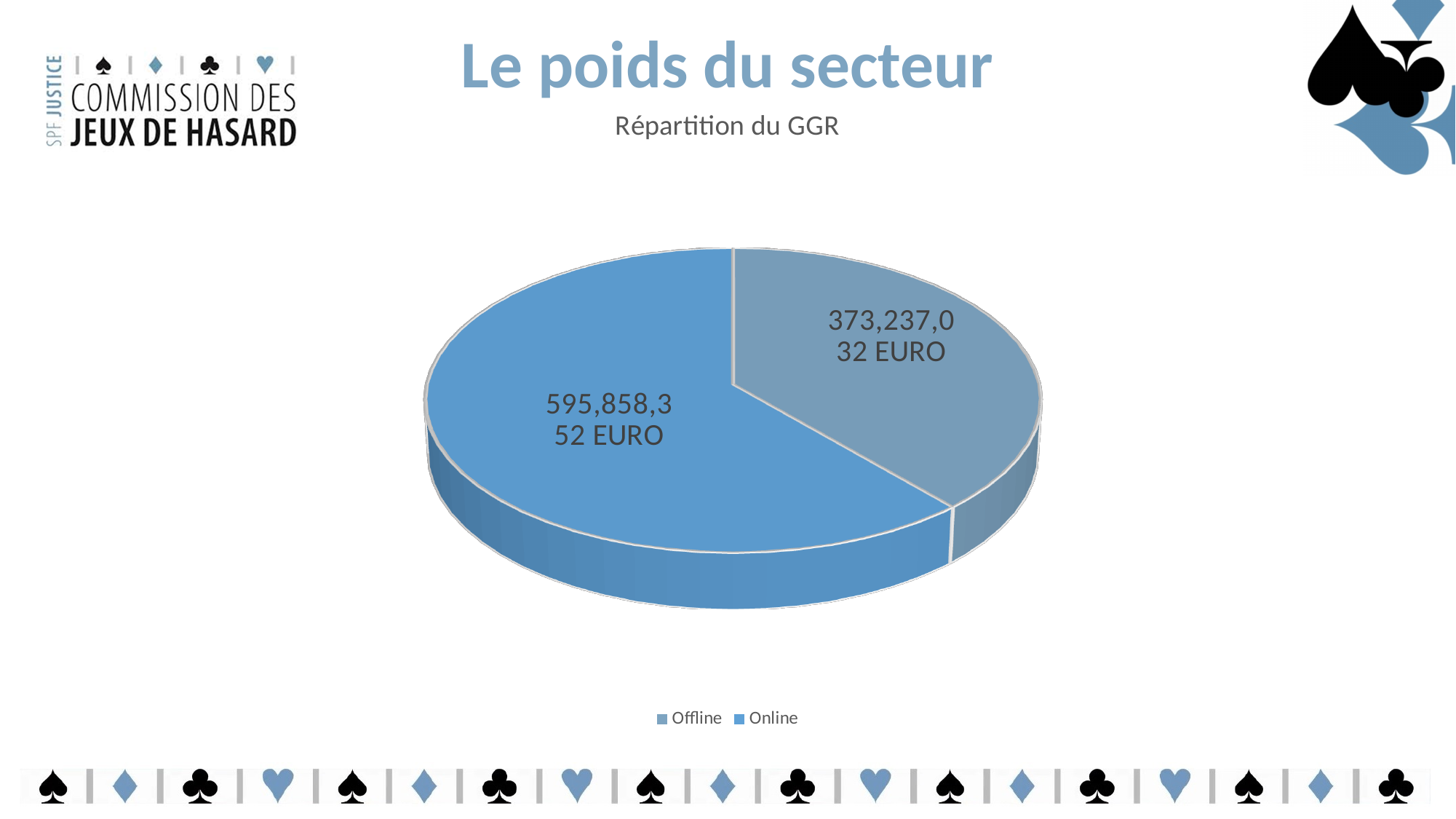
Which slice is the largest? Online What is the title of the chart? Répartition du GGR What are the two legend entries? Offline and Online What is the value of the Offline slice? 373,237,032 EURO Which slice is the smallest? Offline How many slices does the pie chart have? 2 What is the value of the Online slice? 595,858,352 EURO What kind of chart is shown on the slide? Pie chart How many series does the legend list? 2 What is the total of the two slices? 969,095,384 EURO What is the difference between the Online and Offline values? 222,621,320 EURO Which is larger, Online or Offline? Online